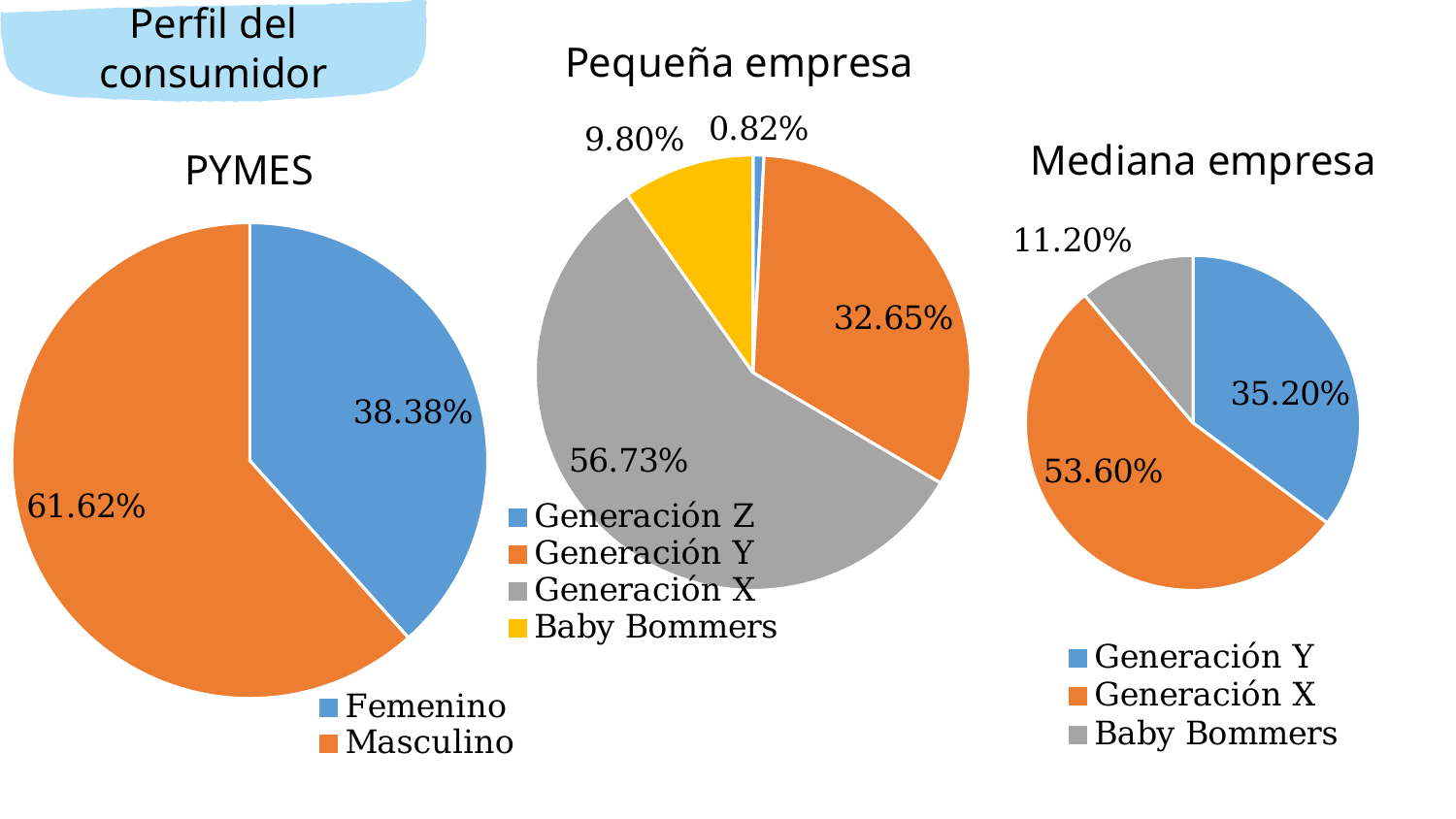
In the PYMES chart, what is the difference between the Masculino and Femenino shares? 23.24% In the PYMES chart, what share is Masculino? 61.62% How many categories does the Pequeña empresa chart show? 4 In the Mediana empresa chart, what is the difference between Generación X and Generación Y? 18.40% In the PYMES chart, what share is Femenino? 38.38% In the Pequeña empresa chart, what share is Generación Z? 0.82% In the Pequeña empresa chart, what share is Generación X? 56.73% In the Pequeña empresa chart, which category has the smallest share? Generación Z In the Mediana empresa chart, which is larger, Generación Y or Baby Bommers? Generación Y In the PYMES chart, which category has the larger share? Masculino What type of chart is the Mediana empresa chart? Pie chart In the Mediana empresa chart, what share is Generación X? 53.60%